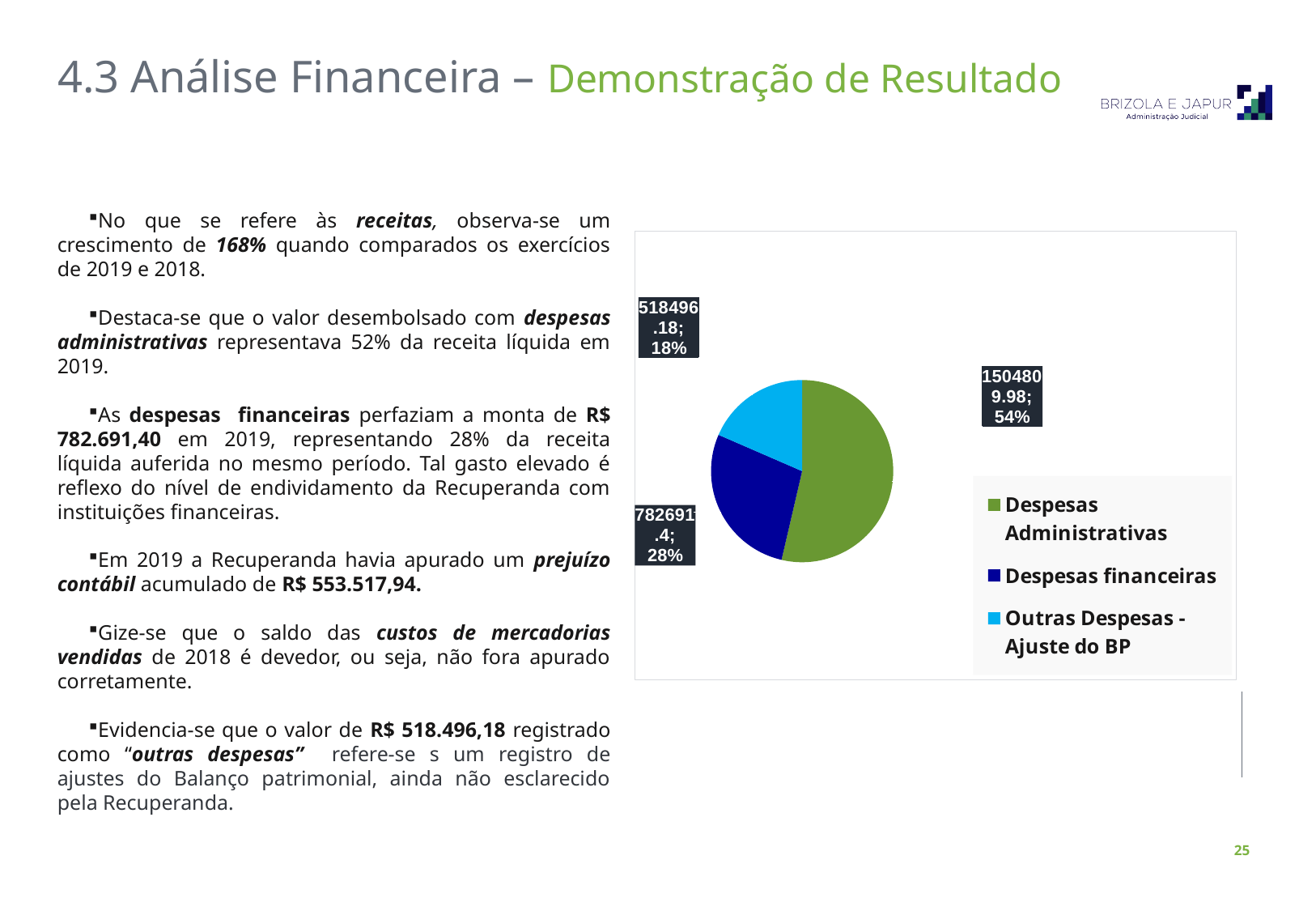
Which colour represents Despesas financeiras in the pie chart? Dark blue Which category has the smallest slice in the pie chart? Outras Despesas - Ajuste do BP What value is labelled for Despesas Administrativas in the pie chart? 1504809.98 What value is labelled for Despesas financeiras in the pie chart? 782691.4 What percentage share does the Despesas financeiras slice represent? 28% Which category has the largest slice in the pie chart? Despesas Administrativas How many entries does the legend of the pie chart list? 3 How many slices does the pie chart have? 3 What percentage share does the Despesas Administrativas slice represent? 54% What value is labelled for Outras Despesas - Ajuste do BP in the pie chart? 518496.18 What kind of chart is shown on the slide? Pie chart What percentage share does the Outras Despesas - Ajuste do BP slice represent? 18%